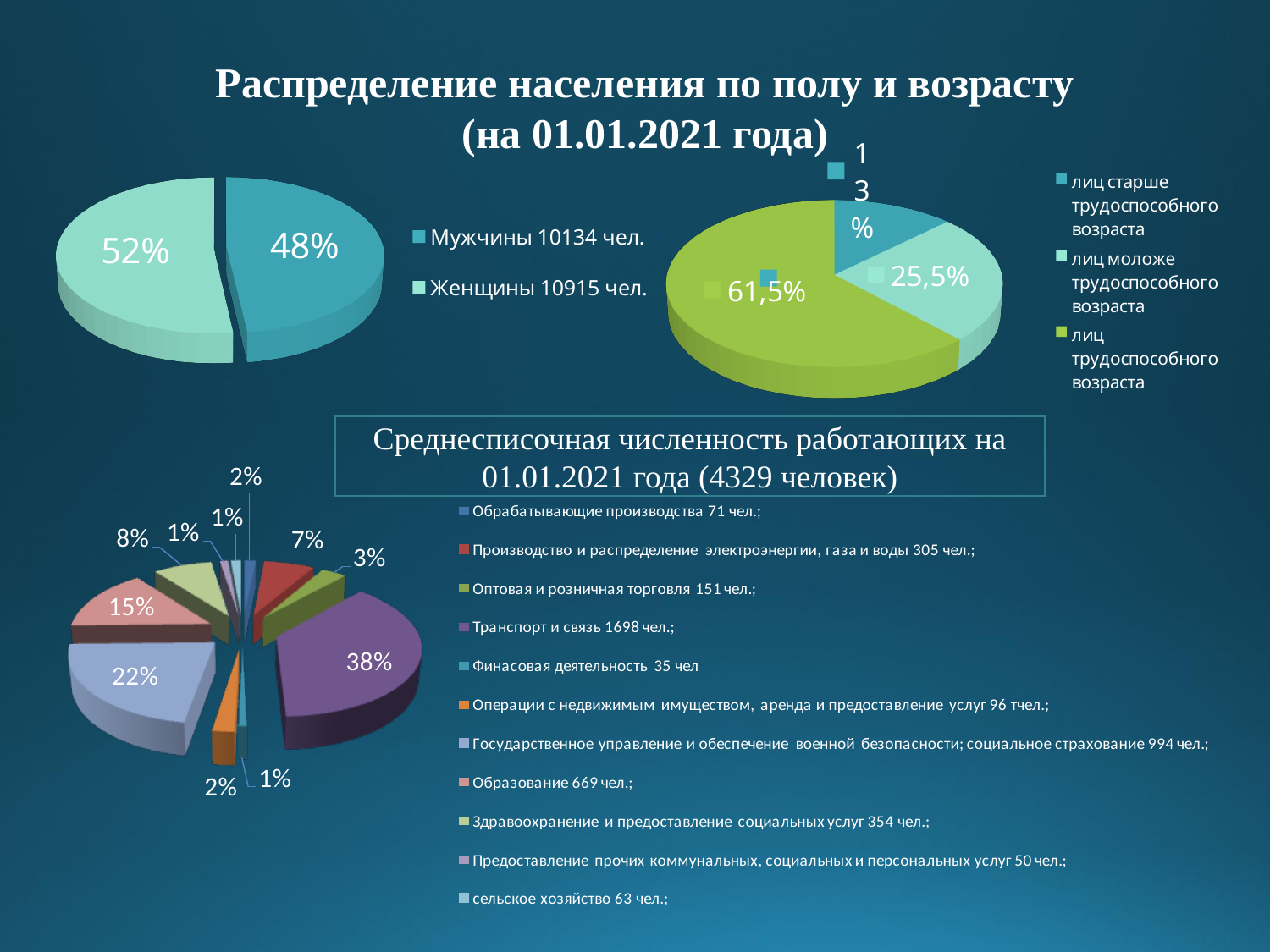
In the top-left pie chart, what share is shown for Мужчины? 48% In the top-right pie chart, what share is shown for лиц моложе трудоспособного возраста? 25,5% In the top-left pie chart, which group has the larger share, Мужчины or Женщины? Женщины In the top-left pie chart, what share is shown for Женщины? 52% In the top-left pie chart, how many people does the legend give for Мужчины? 10134 чел. How many entries does the legend of the top-right pie chart list? 3 In the bottom-left pie chart, what is the share of the largest slice? 38% In the top-right pie chart, what share is shown for лиц старше трудоспособного возраста? 13% In the top-right pie chart, what share is shown for лиц трудоспособного возраста? 61,5% How many categories does the legend of the bottom-left pie chart list? 11 What kind of chart is the top-left chart? pie chart In the top-right pie chart, which category has the largest share? лиц трудоспособного возраста